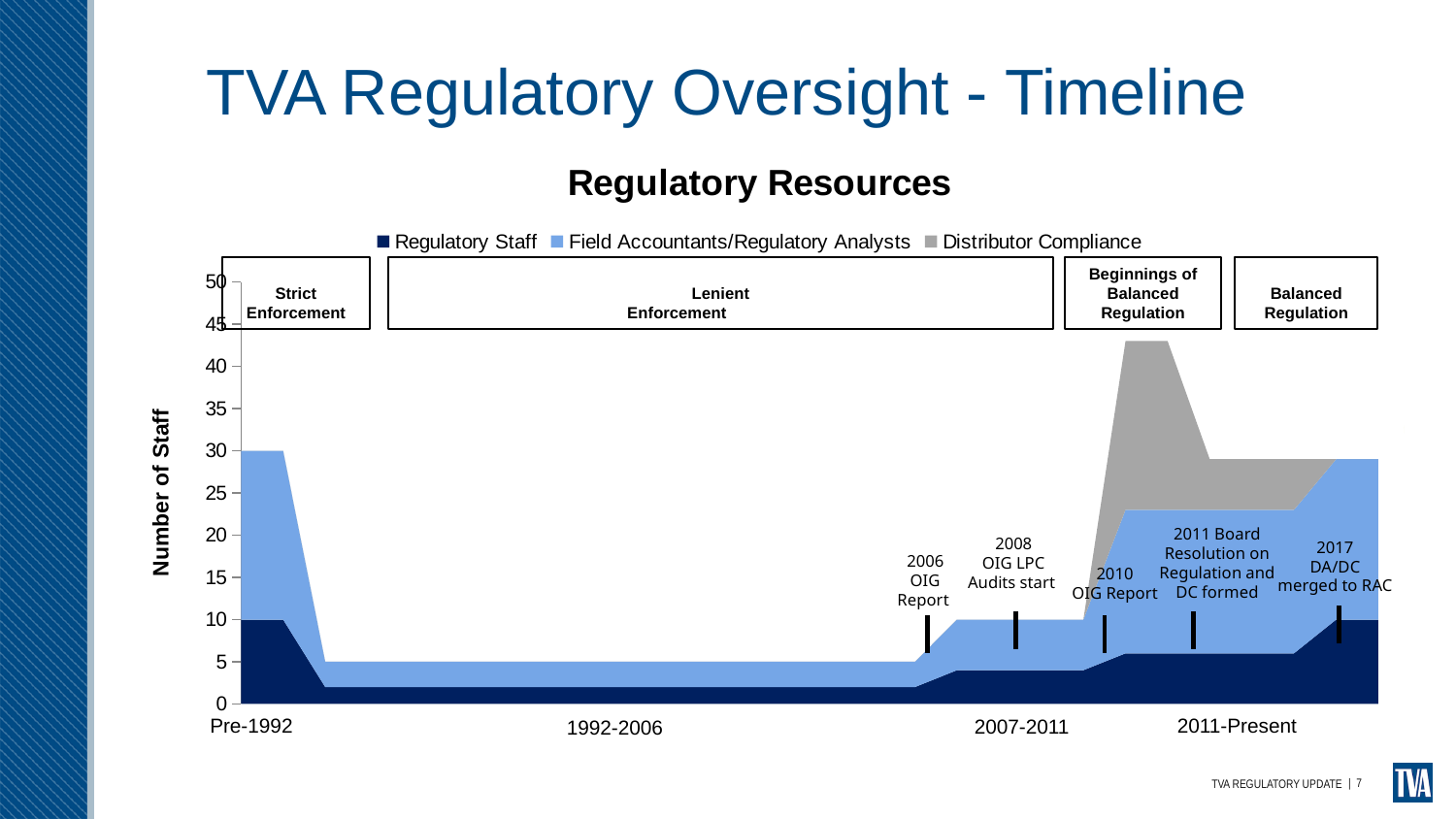
Which period shows the lowest total number of staff? 1992-2006 What is the title of the chart? Regulatory Resources What is the number of Regulatory Staff shown at the start of the Pre-1992 period? 10 Which series is shown in grey in the chart? Distributor Compliance What is the label of the vertical axis? Number of Staff Does the total number of staff rise or fall from Pre-1992 to 1992-2006? fall How many series does the legend of the Regulatory Resources chart list? 3 Is the peak total number of staff in the 2011-Present period greater or less than 40? greater What kind of chart is shown on the slide? Stacked area chart Is the total number of staff during the 1992-2006 period greater or less than 10? less How many time periods are labelled on the x axis of the chart? 4 What is the total number of staff shown at the start of the Pre-1992 period? 30